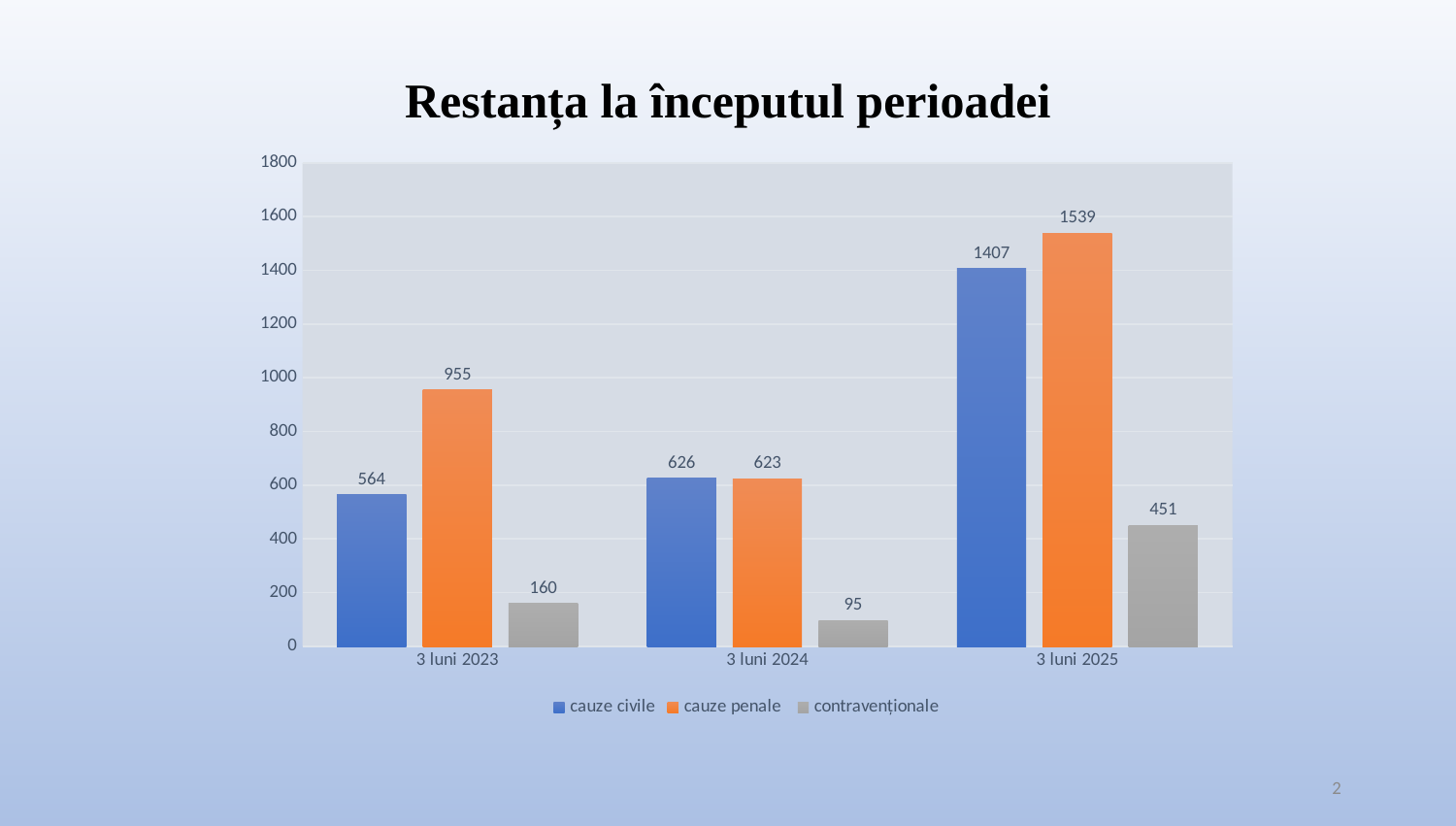
What is the difference between cauze penale and cauze civile in 3 luni 2025? 132 Which is larger in 3 luni 2023: cauze civile or cauze penale? cauze penale What is the value for cauze penale in 3 luni 2023? 955 How many series does the legend list? 3 What is the title of the chart? Restanța la începutul perioadei What is the value for cauze civile in 3 luni 2025? 1407 What is the value for contravenționale in 3 luni 2024? 95 Which period has the highest value for cauze penale? 3 luni 2025 Which period has the lowest value for contravenționale? 3 luni 2024 What kind of chart is shown on the slide? bar chart Do the values for cauze civile rise or fall from 3 luni 2023 to 3 luni 2025? rise How many periods are shown on the x axis? 3